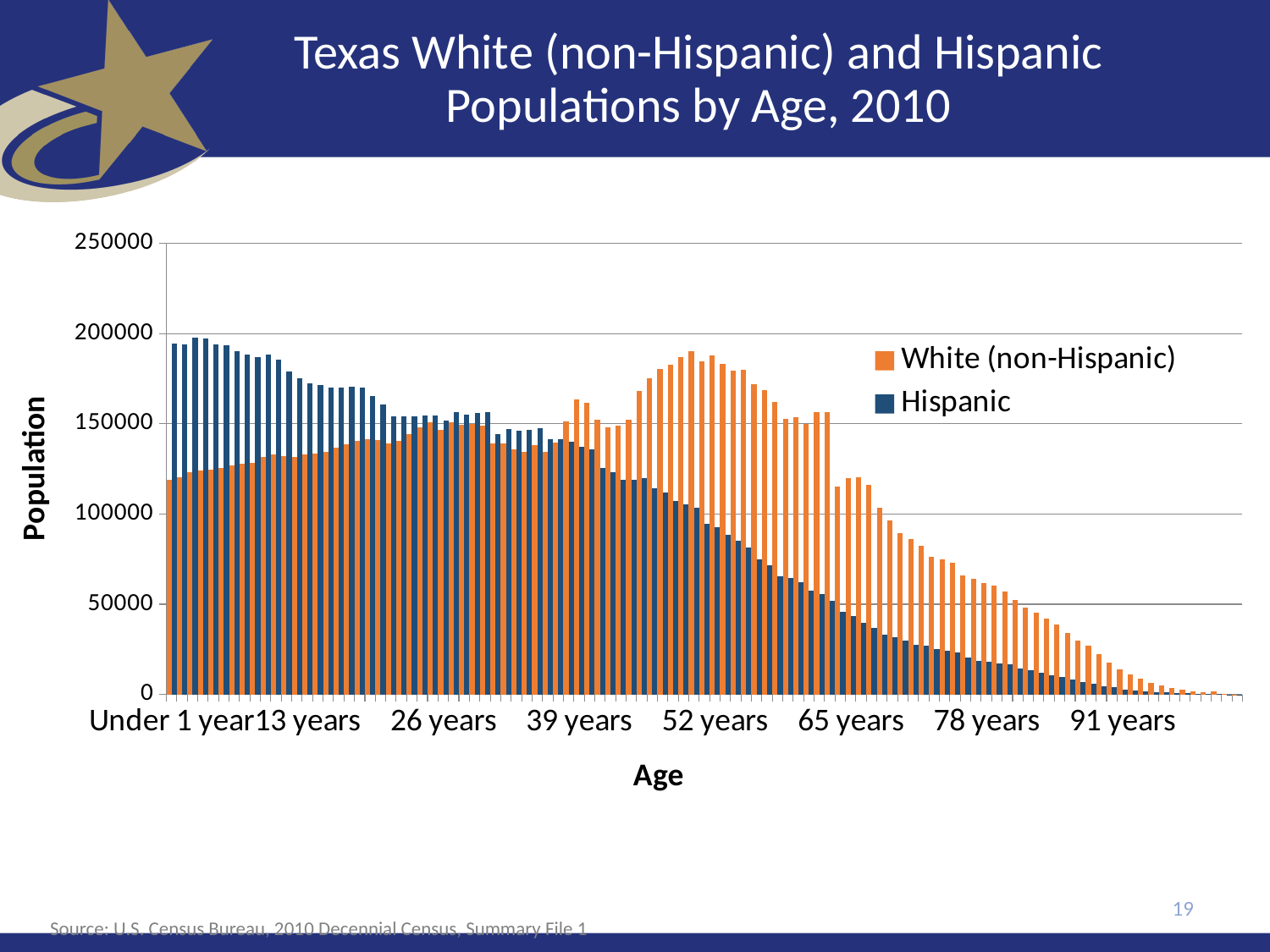
Is the White (non-Hispanic) value for Under 1 year greater or less than 150000? less Which colour represents the Hispanic series in the chart? blue Which series has the larger value at 52 years, White (non-Hispanic) or Hispanic? White (non-Hispanic) Is the Hispanic value for 78 years greater or less than 50000? less Is the Hispanic value for 52 years greater or less than 100000? less Which series has the larger value at Under 1 year, White (non-Hispanic) or Hispanic? Hispanic What kind of chart is shown on the slide? bar chart How many series does the legend list? 2 What is the title of the chart? Texas White (non-Hispanic) and Hispanic Populations by Age, 2010 Do the Hispanic values generally rise or fall as age increases along the x axis? fall